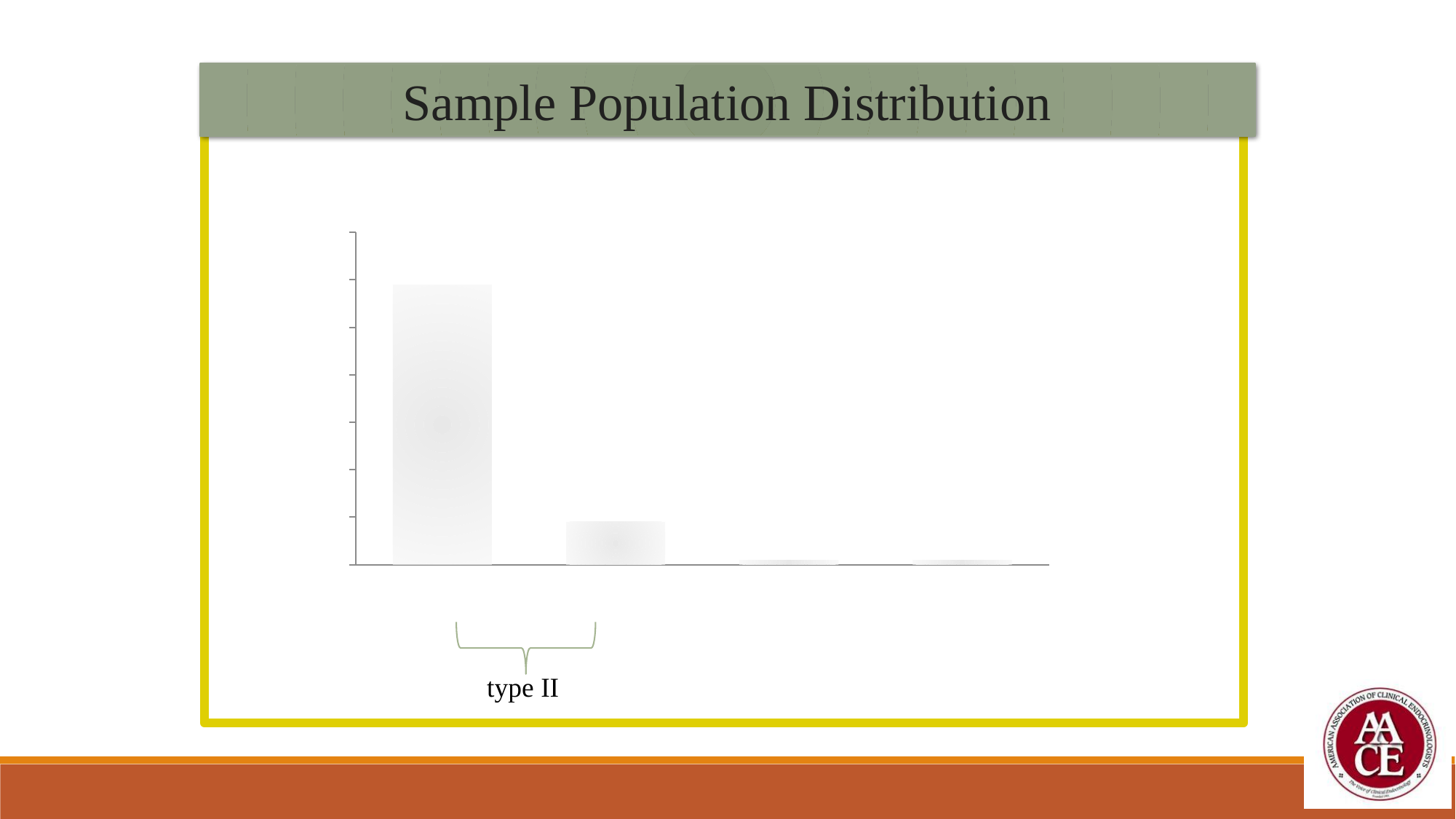
Which bar in the chart is the tallest, by position? the first (leftmost) bar Do the bar heights rise or fall from left to right across the chart? fall Is the first (leftmost) bar taller or shorter than the second bar? taller What kind of chart is shown on the slide? bar chart What label is written under the bracket beneath the first two bars? type II How many bars are plotted in the chart? 4 What is the title of the chart on the slide? Sample Population Distribution